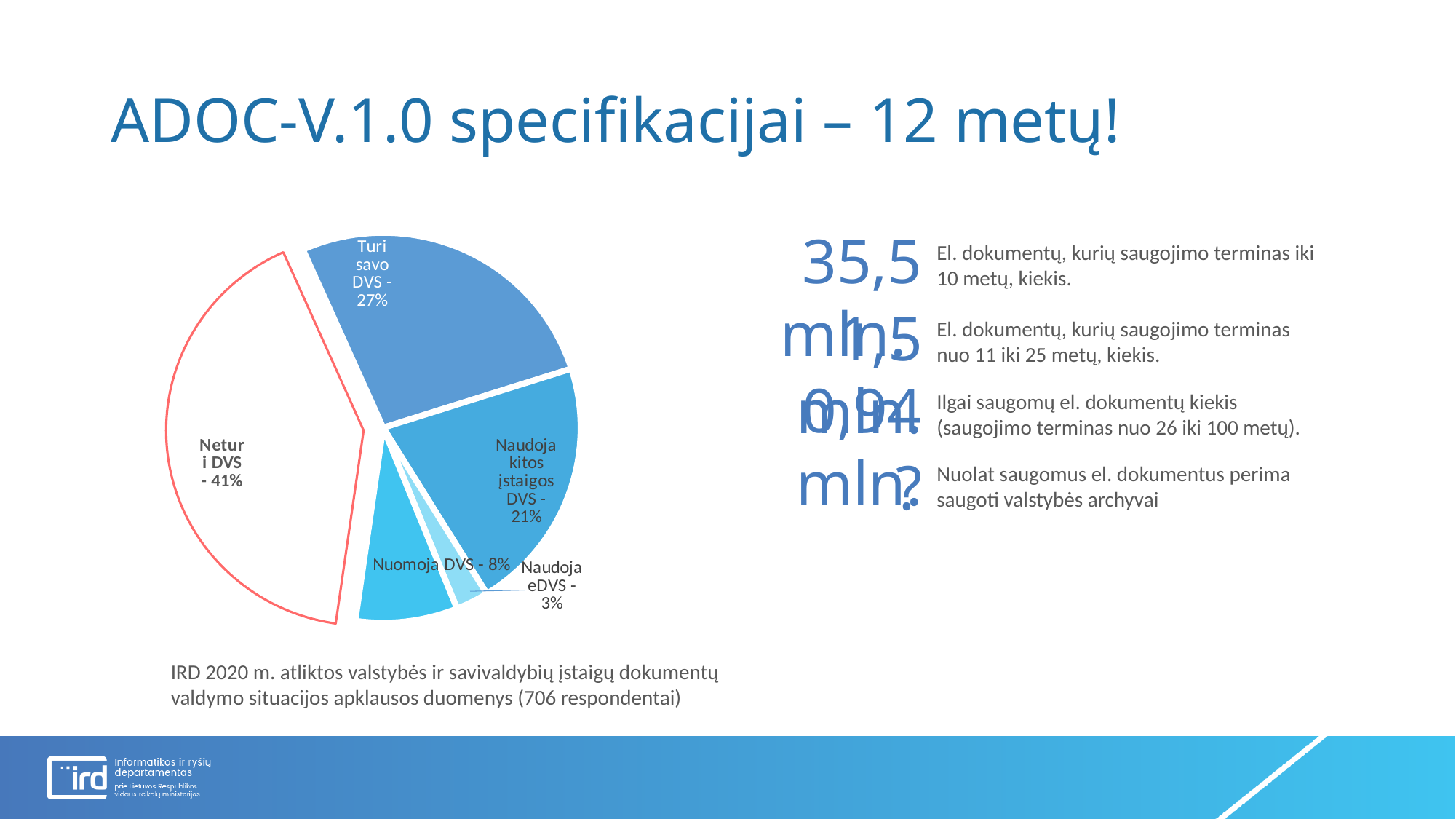
What share of the pie is labelled "Naudoja eDVS"? 3% What is the difference in percentage points between the "Neturi DVS" slice and the "Turi savo DVS" slice? 14 Which slice of the pie chart is the smallest? Naudoja eDVS Which slice of the pie chart is the largest? Neturi DVS What kind of chart is shown on the slide? pie chart What share of the pie is labelled "Nuomoja DVS"? 8% How many slices does the pie chart have? 5 How many respondents does the caption below the pie chart say the survey had? 706 What share of the pie is labelled "Naudoja kitos įstaigos DVS"? 21% Which is larger: the "Nuomoja DVS" slice or the "Naudoja kitos įstaigos DVS" slice? Naudoja kitos įstaigos DVS